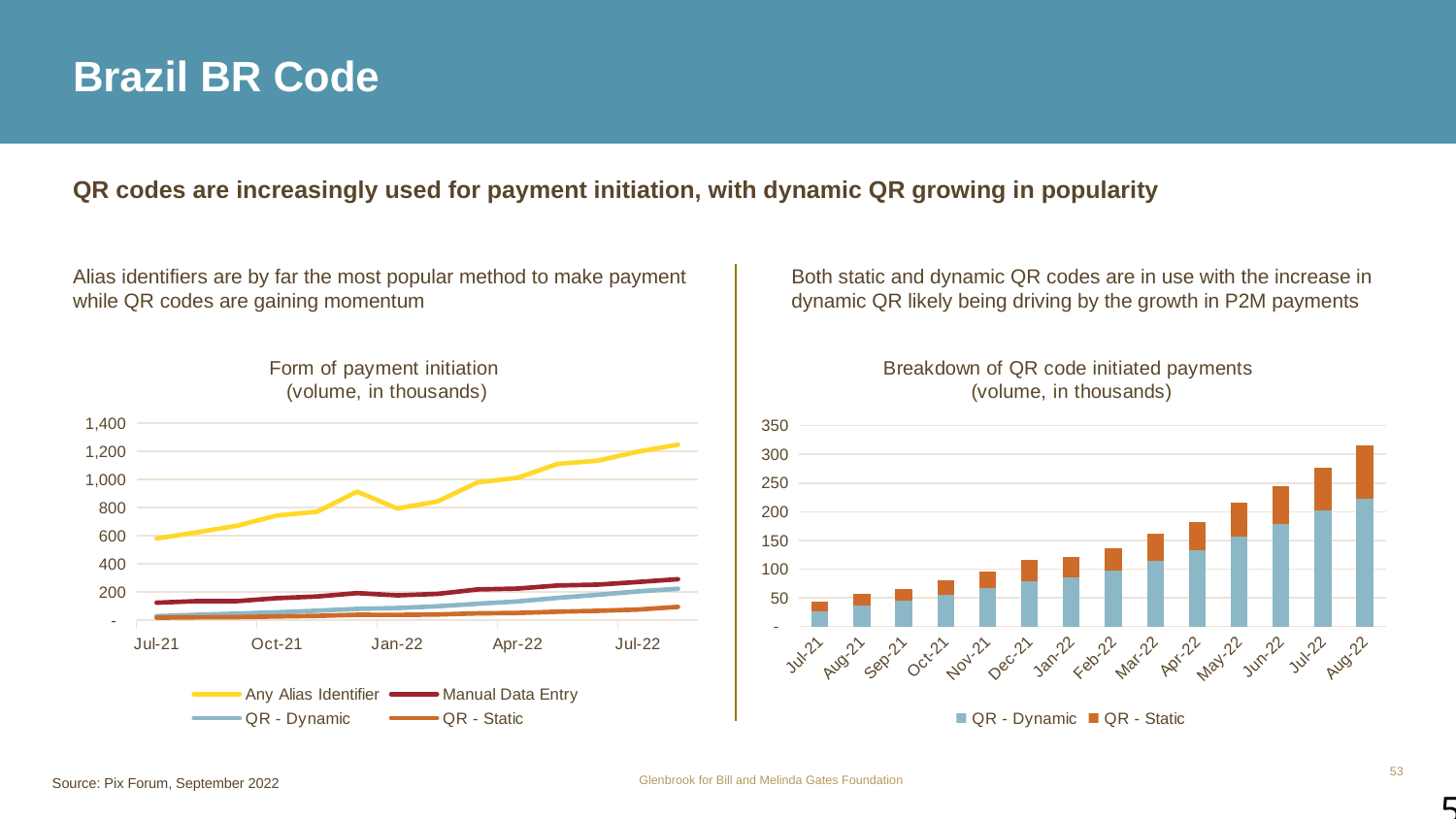
In the 'Breakdown of QR code initiated payments' chart, which month has the tallest stacked bar? Aug-22 How many months are shown on the x axis of the 'Breakdown of QR code initiated payments' chart? 14 How many series does the legend of the 'Form of payment initiation' chart list? 4 In the 'Breakdown of QR code initiated payments' chart, which series is shown in orange? QR - Static In the 'Form of payment initiation' chart, which series has the highest values throughout the period? Any Alias Identifier How many series does the legend of the 'Breakdown of QR code initiated payments' chart list? 2 What kind of chart is the 'Form of payment initiation' chart on the left? line chart What kind of chart is the 'Breakdown of QR code initiated payments' chart on the right? bar chart In the 'Breakdown of QR code initiated payments' chart, which month has the shortest stacked bar? Jul-21 In the 'Form of payment initiation' chart, does the Any Alias Identifier line generally rise or fall from Jul-21 to Jul-22? rise In the 'Breakdown of QR code initiated payments' chart, is the total stacked bar for Aug-22 greater or less than 300? greater